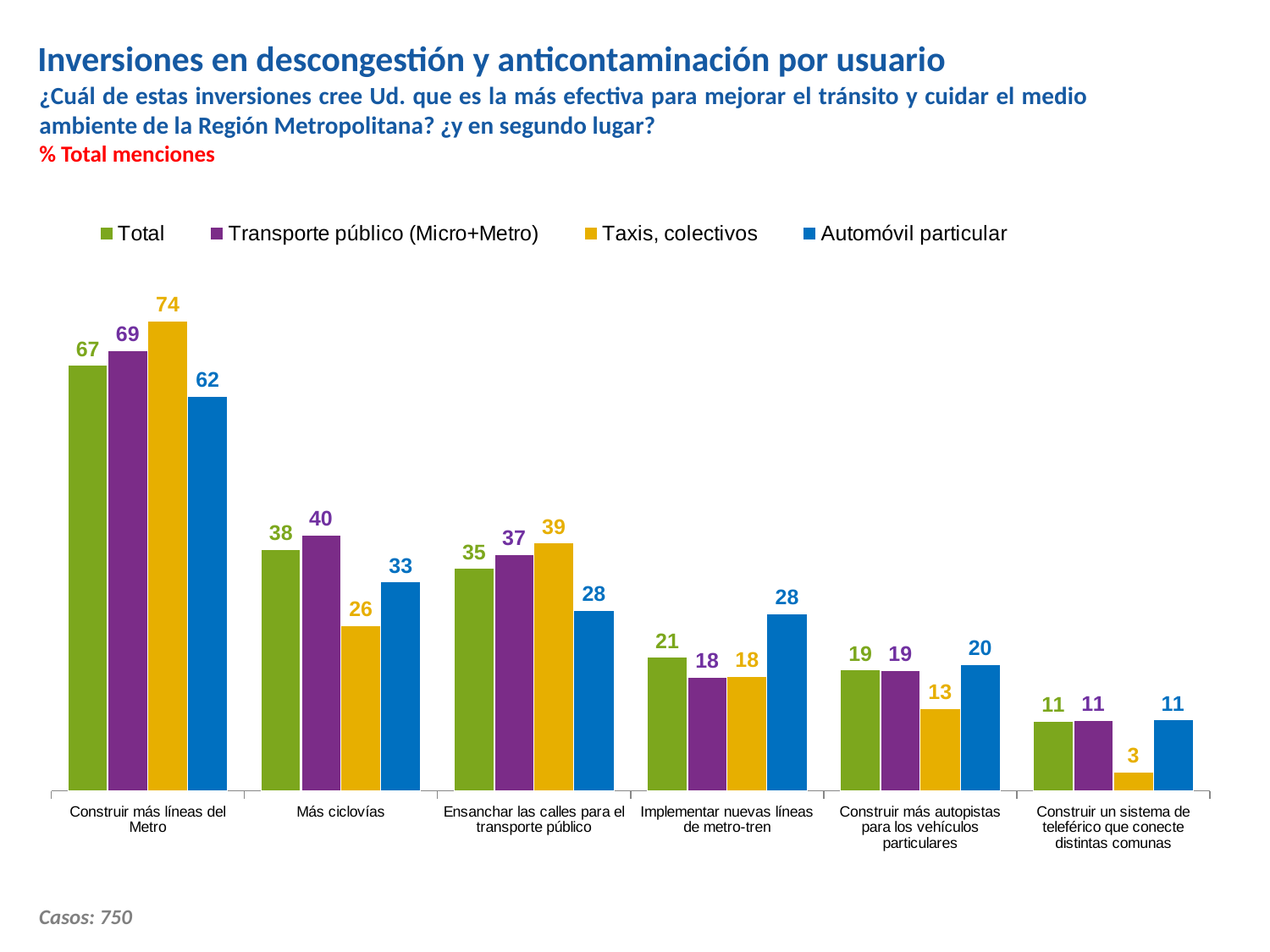
What is the value for "Automóvil particular" in the "Implementar nuevas líneas de metro-tren" category? 28 What is the difference between the "Taxis, colectivos" and "Automóvil particular" values for "Construir más líneas del Metro"? 12 What colour represents the "Taxis, colectivos" series? Yellow What kind of chart is shown on the slide? Bar chart In the "Más ciclovías" category, which is larger: the value for "Transporte público (Micro+Metro)" or for "Automóvil particular"? Transporte público (Micro+Metro) Do the Total values rise or fall from left to right across the categories? Fall Which series has the lowest value in the "Construir un sistema de teleférico que conecte distintas comunas" category? Taxis, colectivos Which category has the highest Total value? Construir más líneas del Metro How many series does the legend list? 4 How many categories are shown on the x axis? 6 What is the Total value for "Construir más líneas del Metro"? 67 What is the value for "Taxis, colectivos" in the "Más ciclovías" category? 26